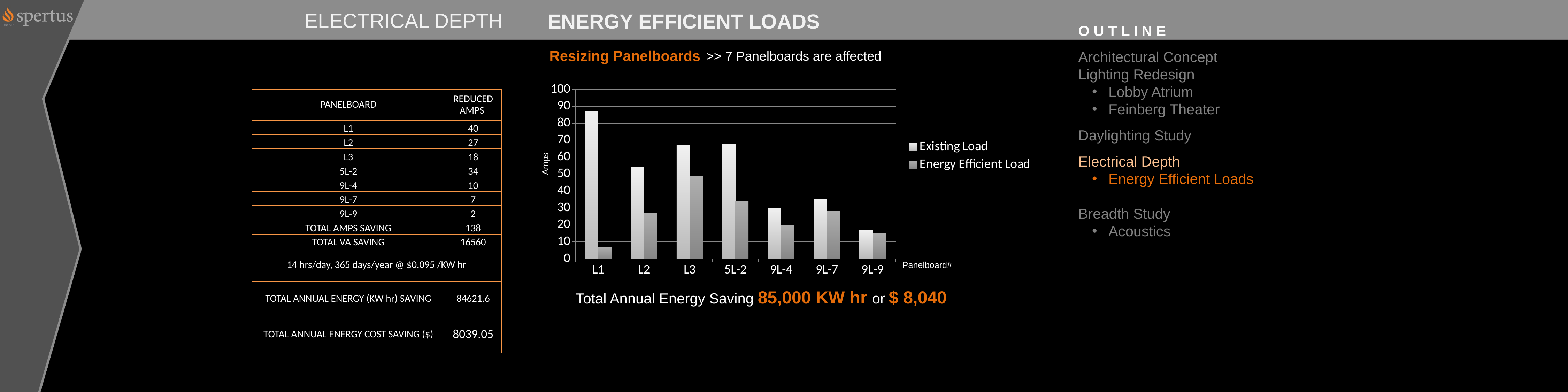
Which panelboard has the highest Energy Efficient Load in the chart? L3 What kind of chart is shown on the slide? bar chart How many panelboards are plotted on the x axis of the chart? 7 Is the Existing Load value for L1 greater or less than 80? greater Which panelboard has the lowest Existing Load in the chart? 9L-9 Which panelboard has the highest Existing Load in the chart? L1 How many series does the chart legend list? 2 Which is larger in the chart: the Existing Load for L1 or the Existing Load for L2? L1 Is the Existing Load value for 9L-9 greater or less than 20? less What is the label on the vertical axis of the chart? Amps Is the Energy Efficient Load value for L1 greater or less than 10? less Which panelboard has the lowest Energy Efficient Load in the chart? L1